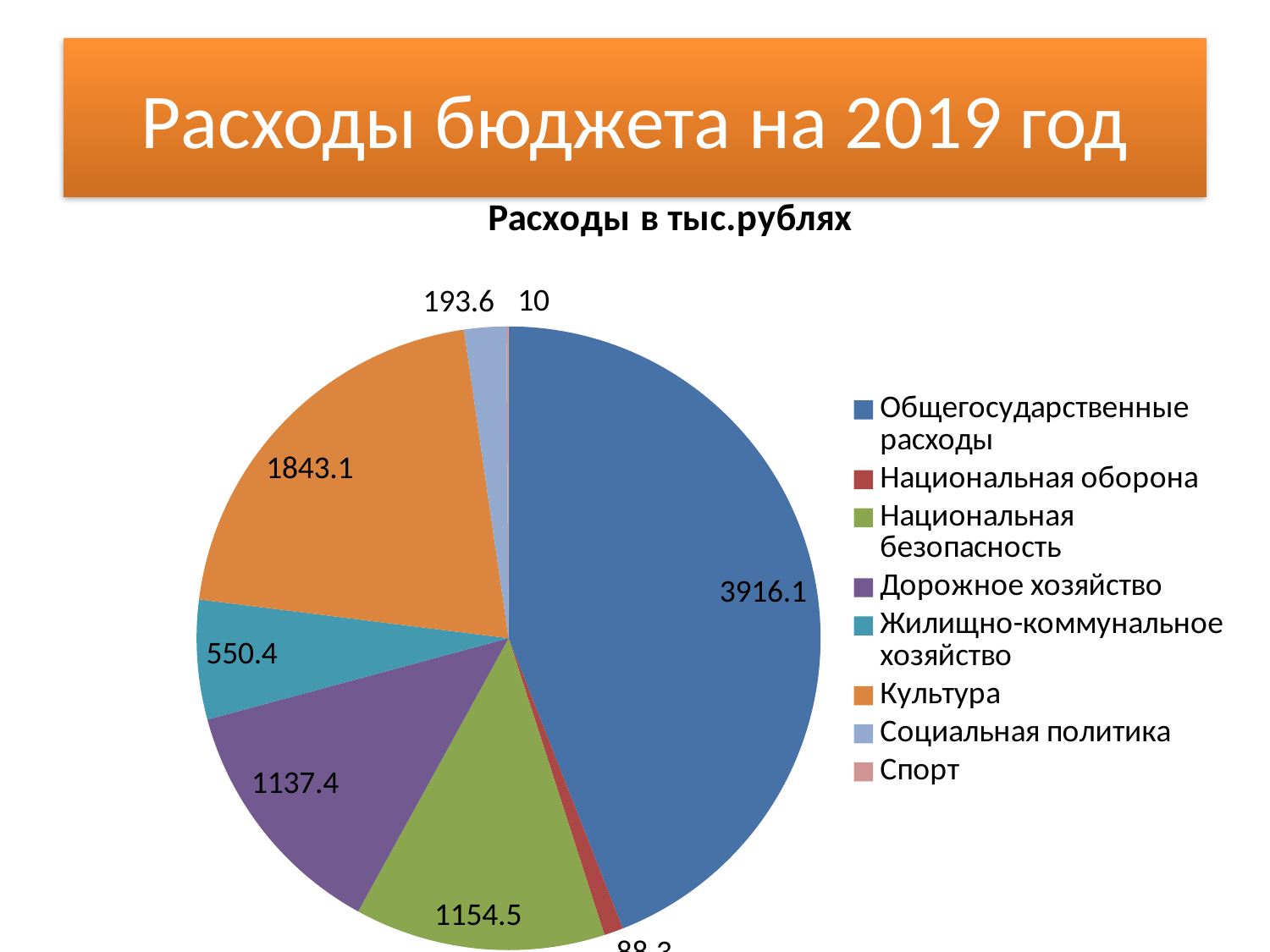
Which category has the largest slice of the pie? Общегосударственные расходы What is the value for Спорт? 10 What is the value for Социальная политика? 193.6 How many categories does the legend list? 8 What is the value for Жилищно-коммунальное хозяйство? 550.4 Which is larger, the value for Национальная безопасность or the value for Дорожное хозяйство? Национальная безопасность Which category has the smallest slice of the pie? Спорт What is the value for Культура? 1843.1 What kind of chart is shown on the slide? pie chart What is the title of the chart? Расходы в тыс.рублях What is the difference between the values for Культура and Жилищно-коммунальное хозяйство? 1292.7 What is the value for Общегосударственные расходы? 3916.1